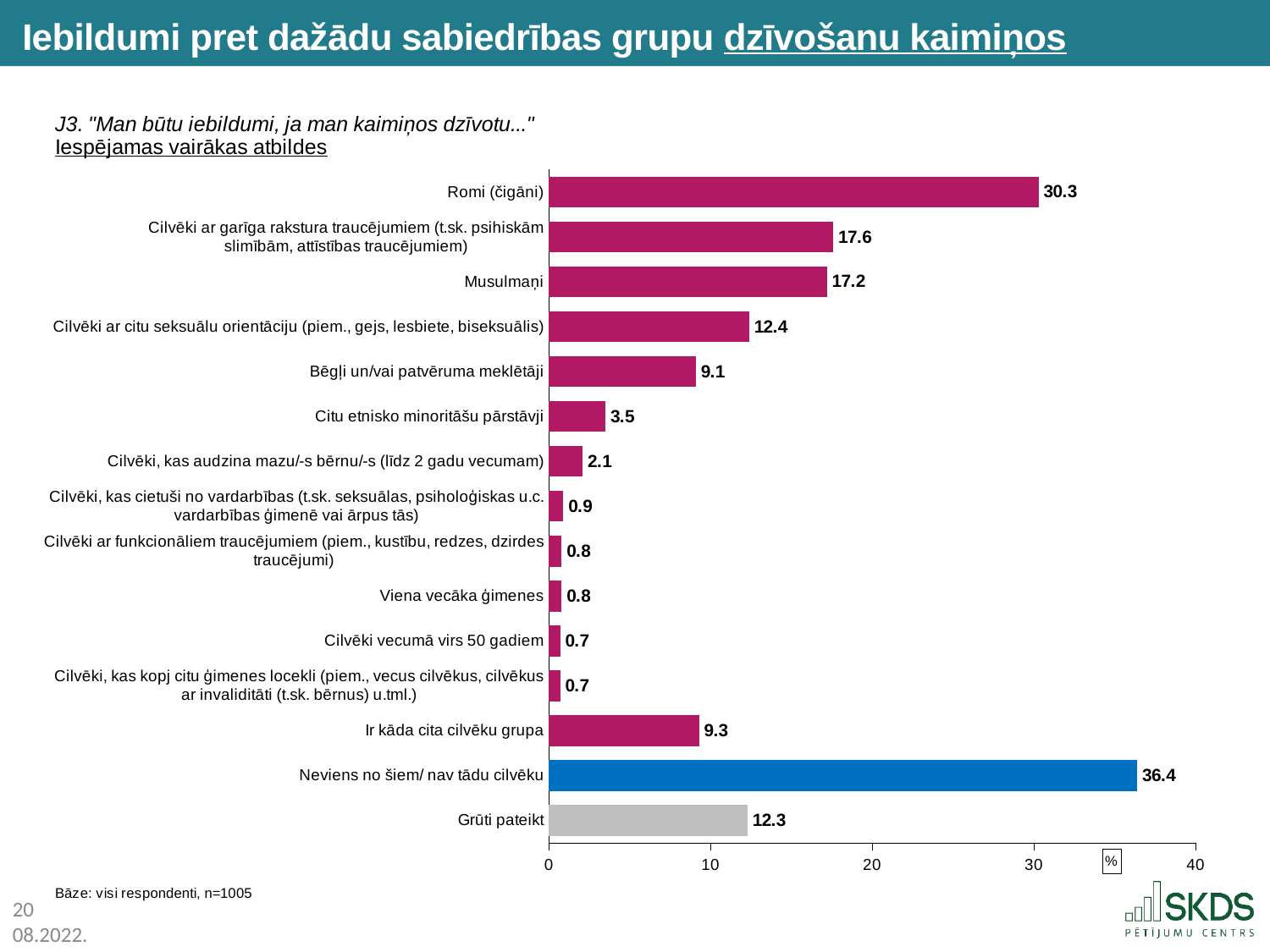
Is the value for Cilvēki ar citu seksuālu orientāciju (piem., gejs, lesbiete, biseksuālis) greater or less than 10? greater Which is larger, the value for Bēgļi un/vai patvēruma meklētāji or the value for Ir kāda cita cilvēku grupa? Ir kāda cita cilvēku grupa What is the value for Romi (čigāni)? 30.3 How many categories are shown in the chart? 15 What is the base (n) stated below the chart? n=1005 What is the value for Citu etnisko minoritāšu pārstāvji? 3.5 What kind of chart is shown on the slide? bar chart What is the value for Musulmaņi? 17.2 What is the value for Grūti pateikt? 12.3 What is the value for Neviens no šiem/ nav tādu cilvēku? 36.4 Which category has the highest value? Neviens no šiem/ nav tādu cilvēku What is the difference between the values for Romi (čigāni) and Musulmaņi? 13.1